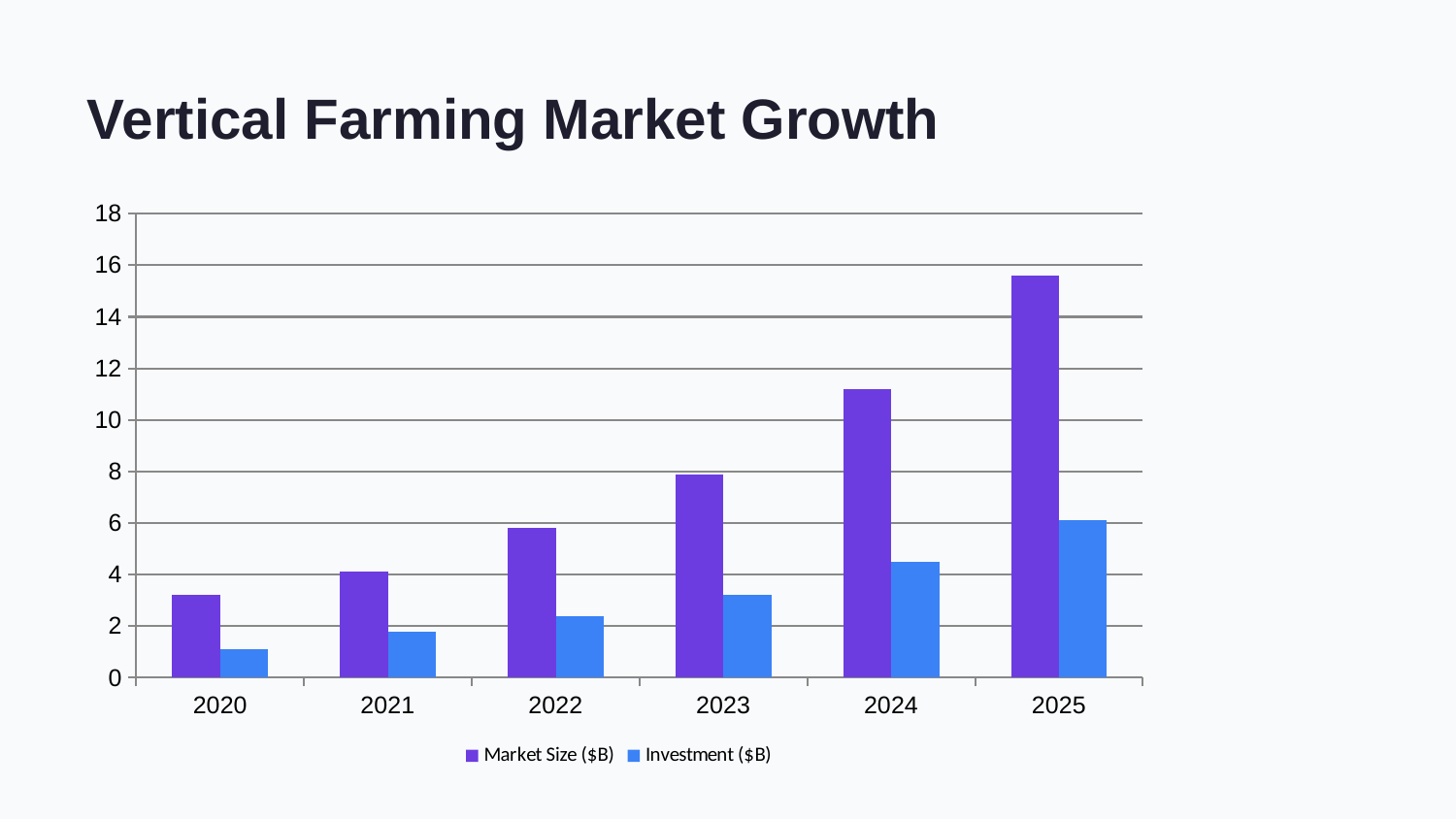
Which year has the highest Market Size ($B)? 2025 Is the Market Size ($B) for 2025 greater or less than 14? greater Which year has the lowest Investment ($B)? 2020 How many years are shown on the x axis? 6 Which is larger in 2024, Market Size ($B) or Investment ($B)? Market Size ($B) What type of chart is shown on the slide? bar chart How many series does the legend list? 2 What is the title of the chart? Vertical Farming Market Growth Does the Market Size ($B) rise or fall from 2020 to 2025? rise Is the Investment ($B) for 2020 greater or less than 2? less Is the Investment ($B) for 2023 greater or less than 4? less